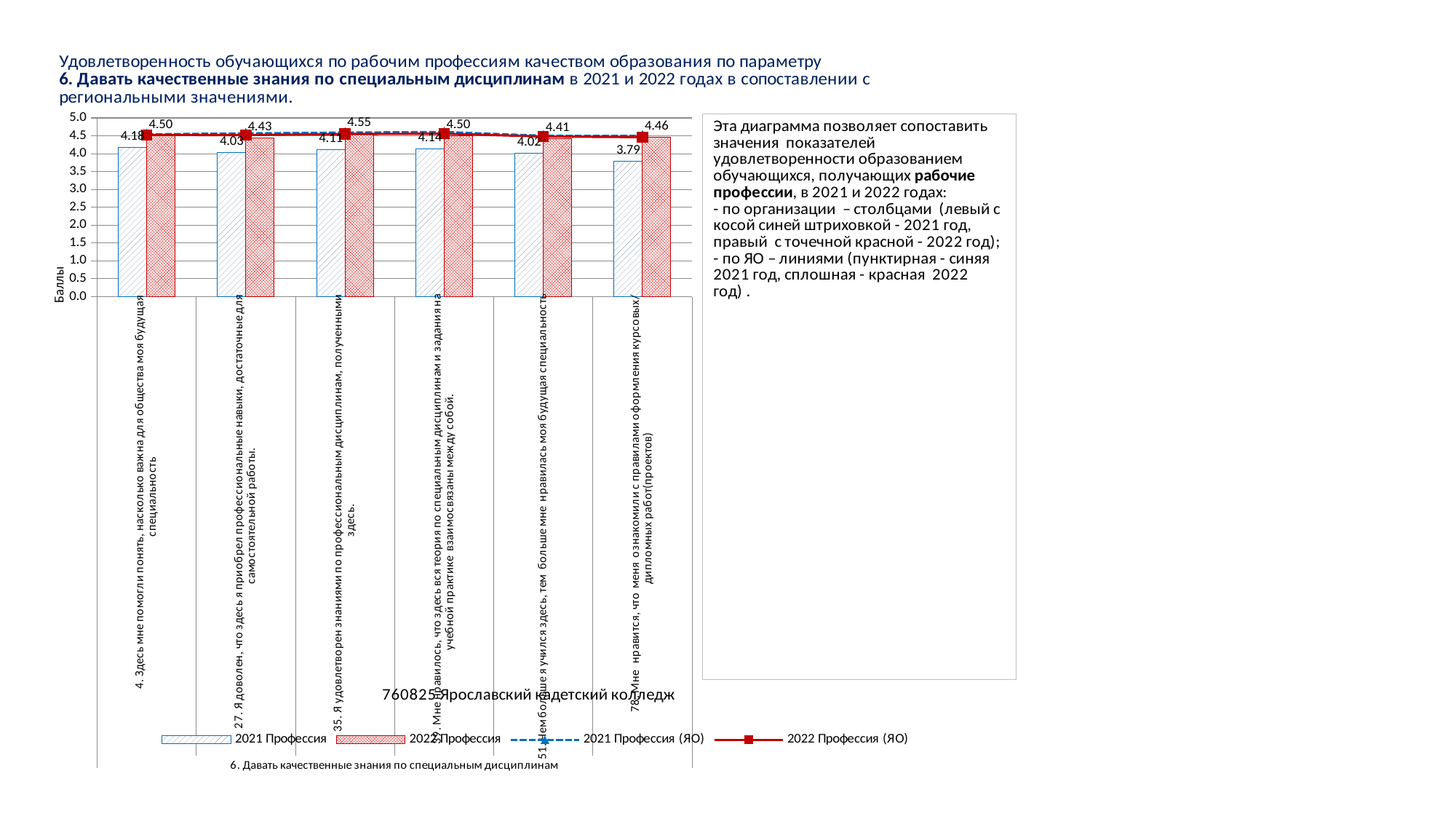
Which category has the highest 2022 Профессия value? 35. Я удовлетворен знаниями по профессиональным дисциплинам, полученными здесь (4.55) How many series does the chart legend list? 4 What is the 2022 Профессия value for category 78 (Мне нравится, что меня ознакомили с правилами оформления курсовых/дипломных работ)? 4.46 What is the 2021 Профессия value for category 4 (Здесь мне помогли понять, насколько важна для общества моя будущая специальность)? 4.18 What is the title of the vertical axis of the chart? Баллы How many categories (questions) are shown on the x axis of the chart? 6 Which category has the lowest 2021 Профессия value? 78. Мне нравится, что меня ознакомили с правилами оформления курсовых/дипломных работ (3.79) Is the 2021 Профессия value for category 78 greater or less than 4.0? less For category 4, what is the difference between the 2022 Профессия value and the 2021 Профессия value? 0.32 For category 78, how much higher is the 2022 Профессия value than the 2021 Профессия value? 0.67 What is the 2022 Профессия value for category 27 (Я доволен, что здесь я приобрел профессиональные навыки)? 4.43 Which is larger: the 2021 Профессия value for category 4 or for category 27? Category 4 (4.18)